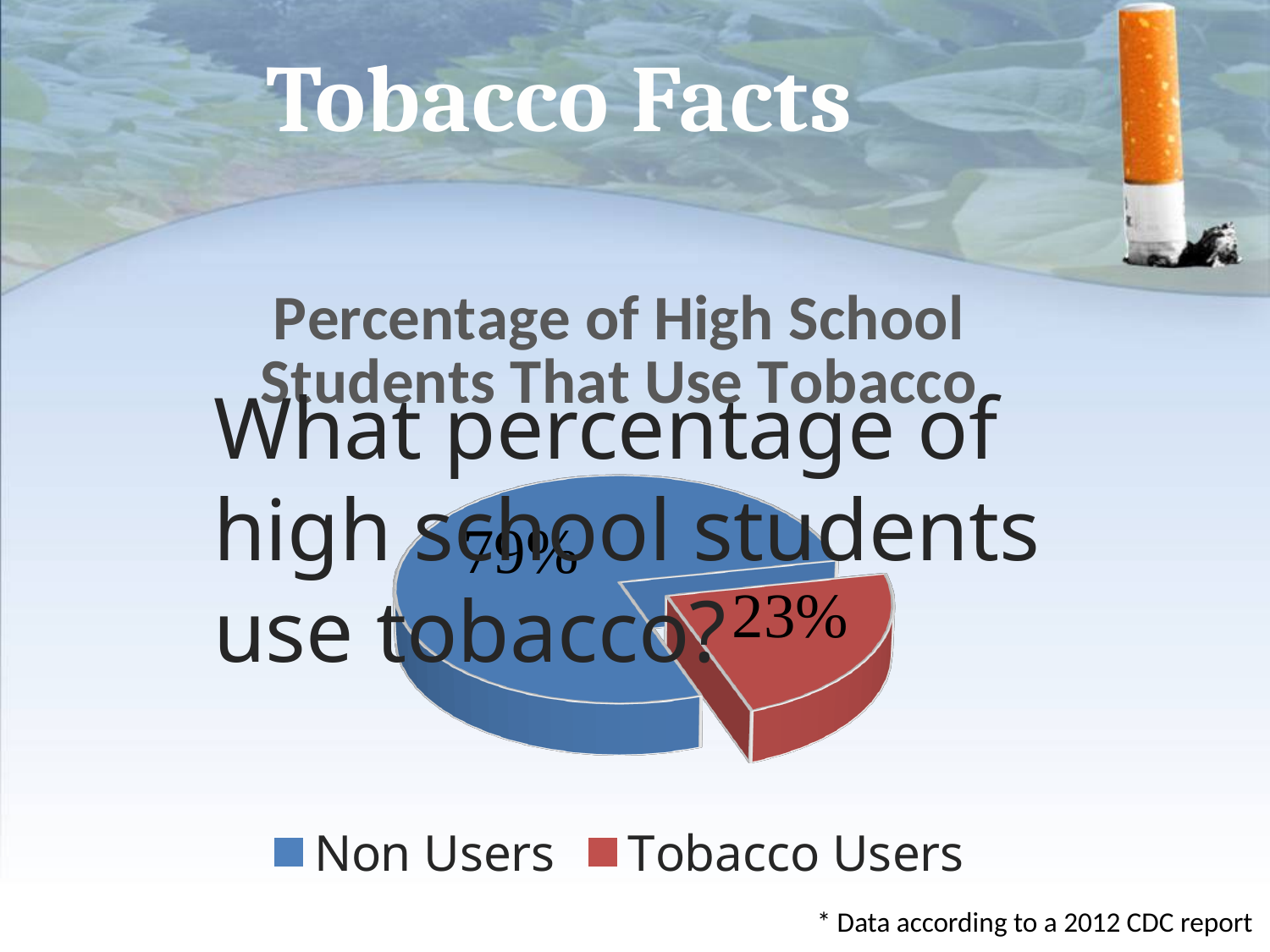
What kind of chart is shown on the slide? pie chart What is the title of the pie chart? Percentage of High School Students That Use Tobacco How many entries does the legend list? 2 Which category has the largest slice of the pie? Non Users Which slice of the pie is larger, Non Users or Tobacco Users? Non Users Which category has the smallest slice of the pie? Tobacco Users What colour is the Tobacco Users slice? red How many slices does the pie chart have? 2 What share of the pie is labelled for Tobacco Users? 23%